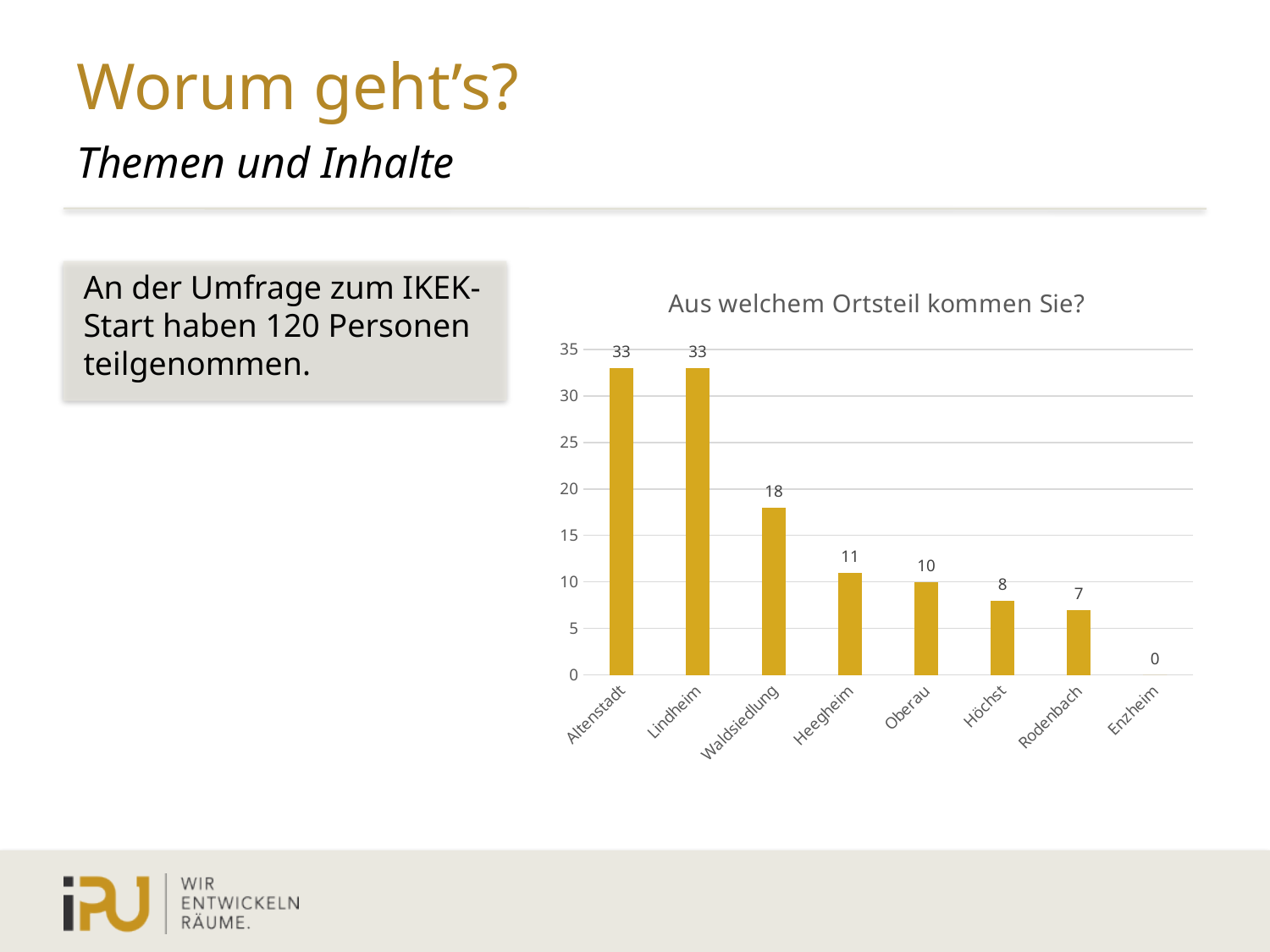
What is the value for Heegheim? 11 Which has a larger value, Lindheim or Heegheim? Lindheim What is the difference between the values for Altenstadt and Waldsiedlung? 15 What is the title of the chart? Aus welchem Ortsteil kommen Sie? What is the value for Rodenbach? 7 What is the value for Enzheim? 0 What type of chart is shown on the slide? Bar chart How many categories (Ortsteile) are shown on the x axis of the chart? 8 Do the values generally rise or fall from left to right along the x axis? Fall What is the difference between the values for Oberau and Höchst? 2 What is the value for Waldsiedlung? 18 Which category has the lowest value? Enzheim